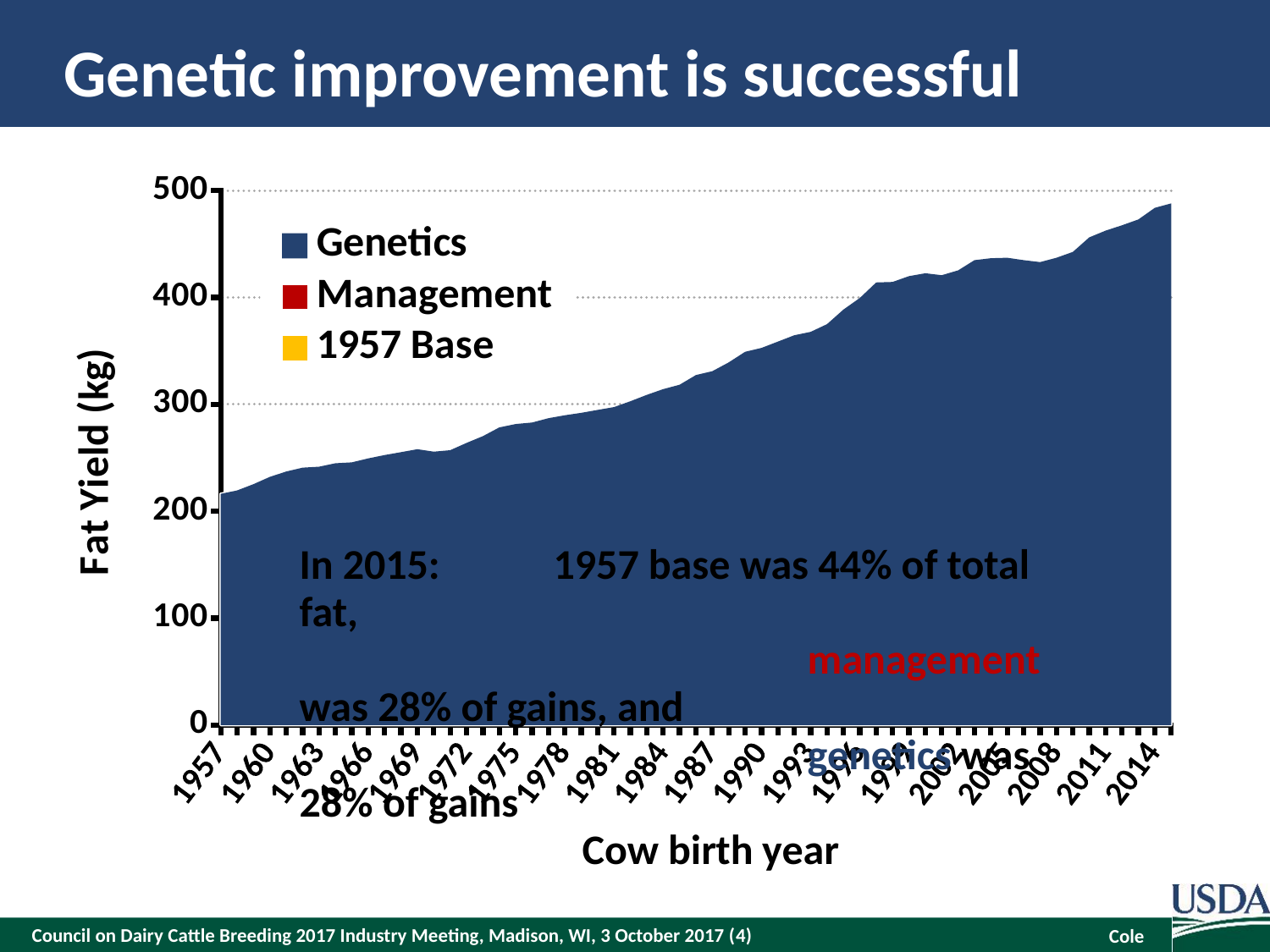
What kind of chart is shown on the slide? area chart How many year labels are shown along the x axis of the chart? 20 Is the plotted value for cow birth year 1990 greater or less than 300? greater Which has the larger plotted value, cow birth year 1966 or cow birth year 1996? 1996 Is the plotted value for cow birth year 1981 greater or less than 400? less What is the title of the x axis of the chart? Cow birth year Is the plotted value for cow birth year 2014 greater or less than 400? greater Do the plotted fat yield values rise or fall as cow birth year increases along the x axis? rise How many series does the chart legend list? 3 What is the title of the y axis of the chart? Fat Yield (kg)